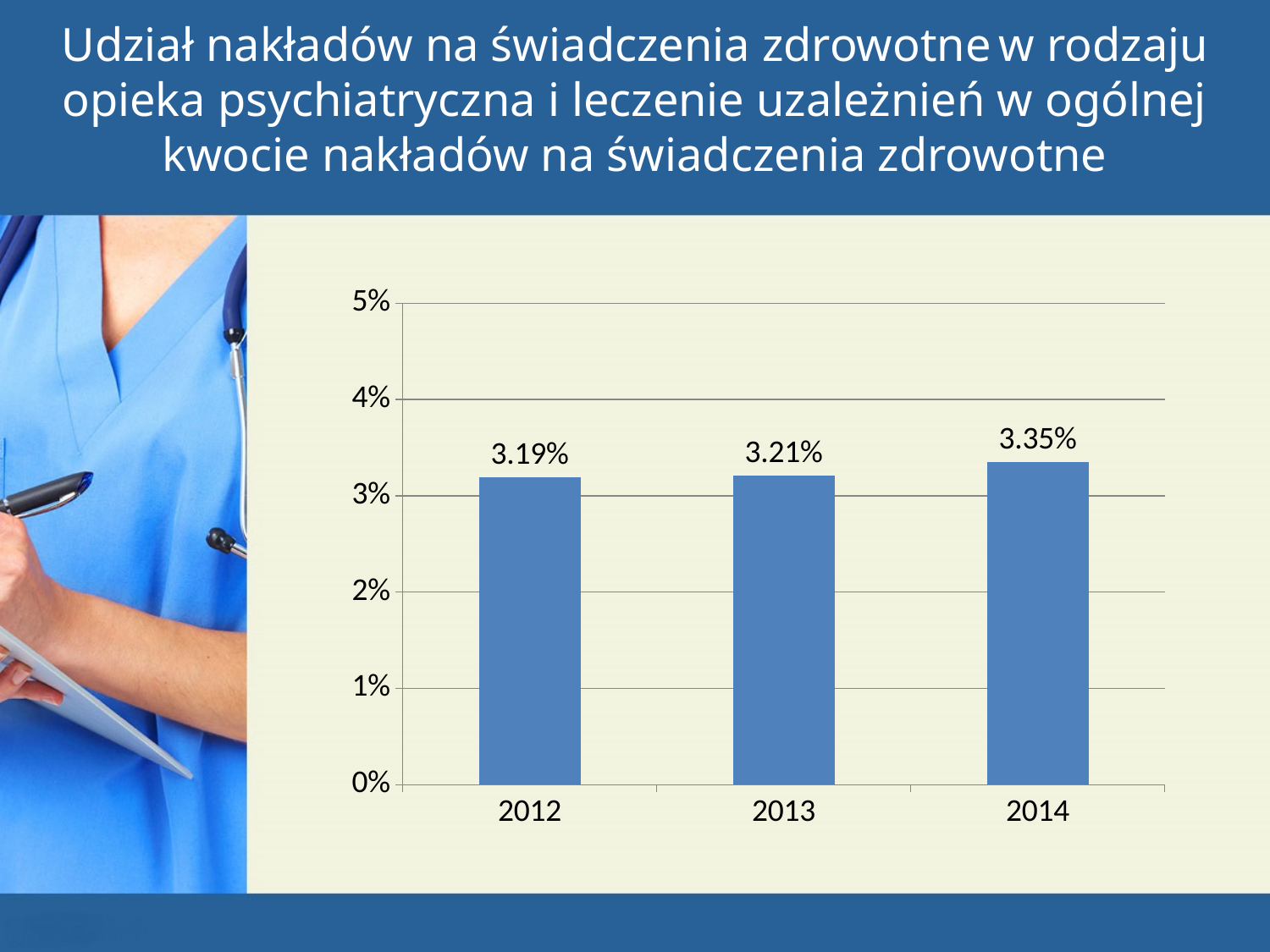
Which year has the highest value? 2014 Which is larger, the value for 2014 or the value for 2012? 2014 Do the values rise or fall from 2012 to 2014? rise What is the difference between the values for 2014 and 2012? 0.16 percentage points What is the difference between the values for 2013 and 2012? 0.02 percentage points What is the value shown for 2014? 3.35% How many years are shown on the x axis? 3 Which year has the lowest value? 2012 Is the value for 2014 greater or less than 4%? less What is the value shown for 2012? 3.19% What kind of chart is shown on the slide? bar chart What is the value shown for 2013? 3.21%